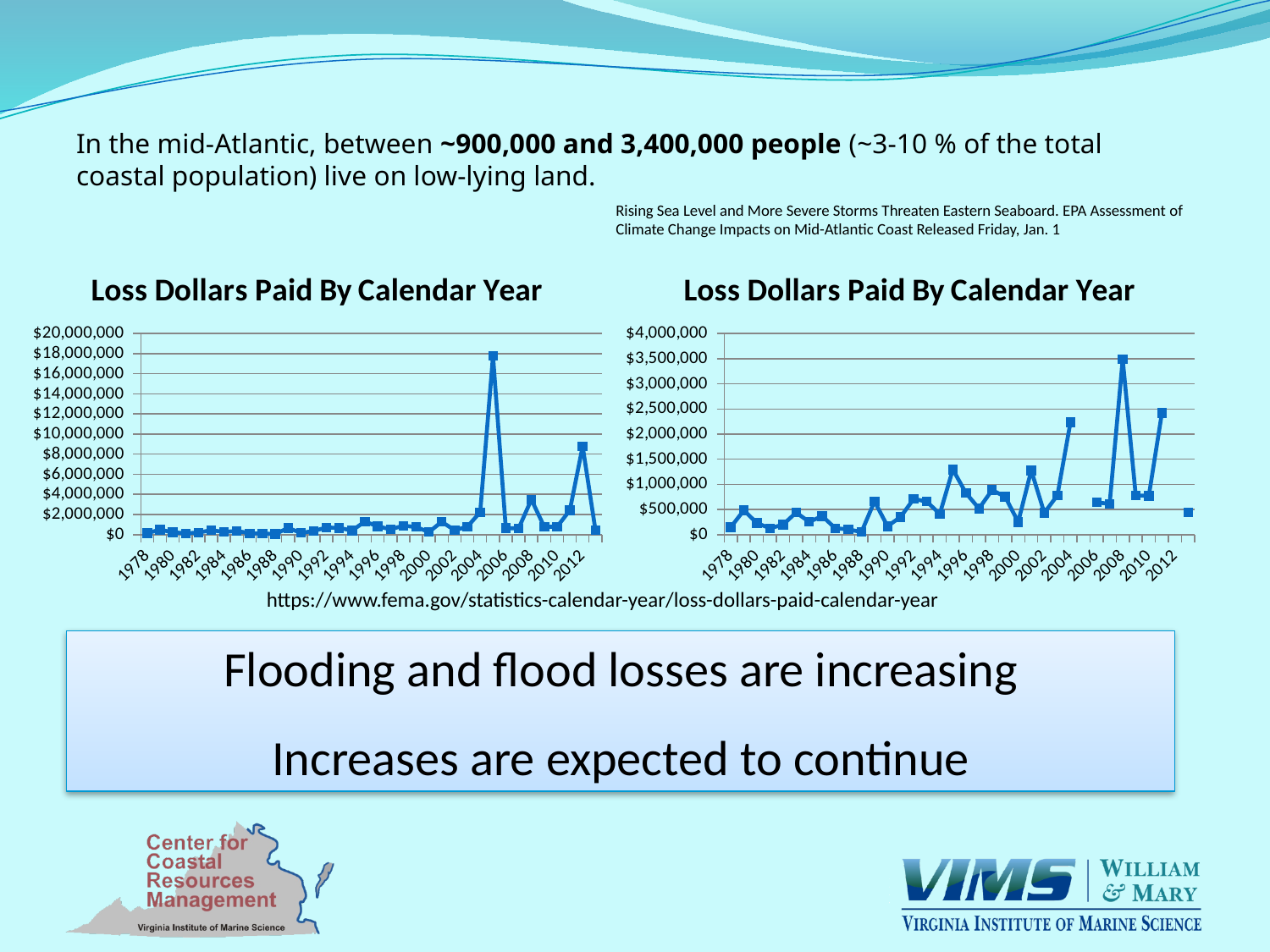
On the left chart, is the value for 1978 greater or less than $2,000,000? less On the right chart, is the highest plotted value greater or less than $3,000,000? greater What is the highest value shown on the y-axis of the left chart? $20,000,000 On the right chart, do the values generally rise or fall from 1978 to 2012? rise What kind of chart is the left chart on the slide? line chart What is the first year labeled on the x-axis of the left chart? 1978 On the left chart, is the highest plotted value greater or less than $16,000,000? greater What is the title of the left chart? Loss Dollars Paid By Calendar Year What is the last year labeled on the x-axis of the right chart? 2012 What kind of chart is the right chart on the slide? line chart